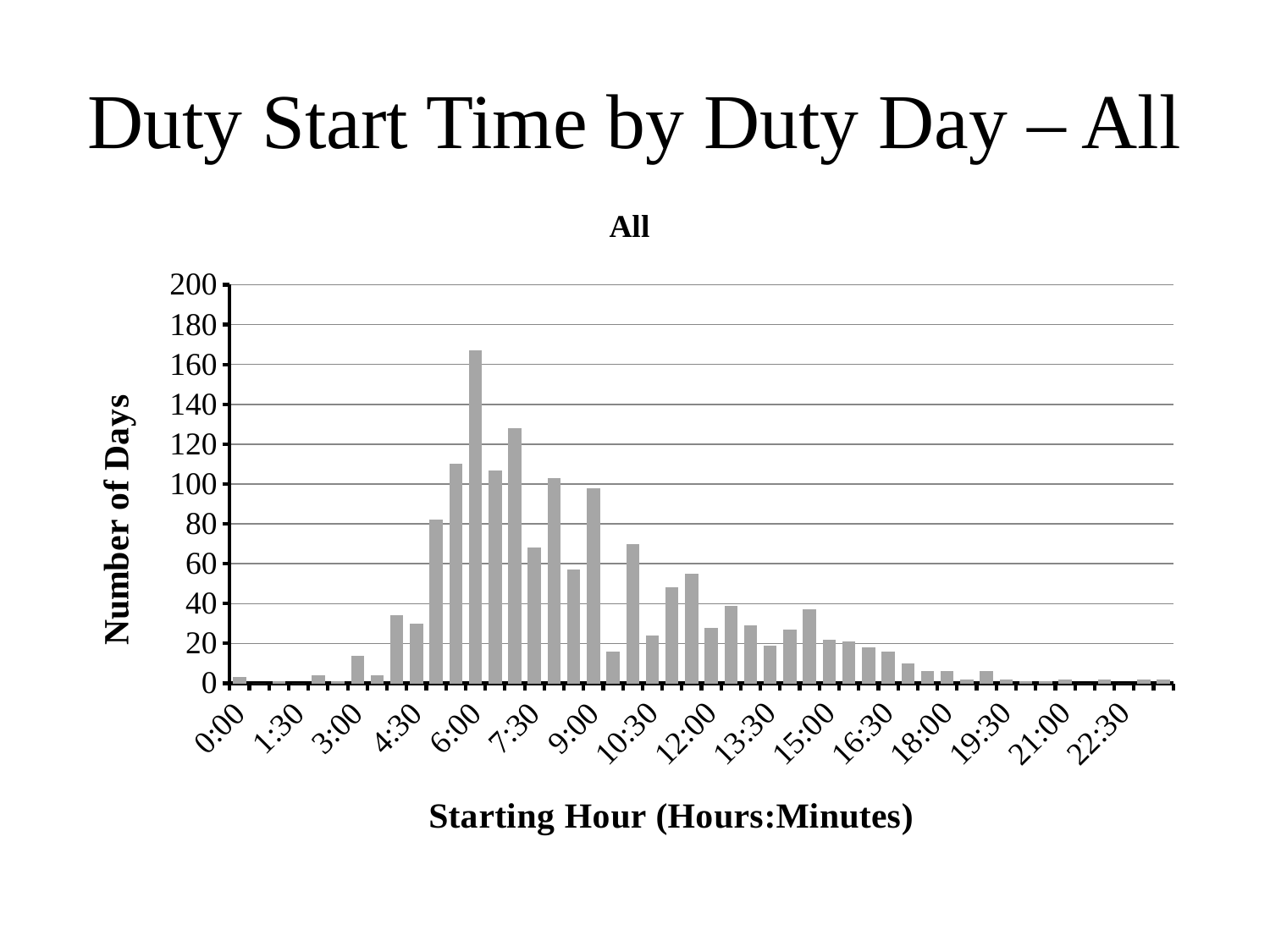
Do the number of days generally rise or fall along the x axis from 6:00 to 18:00? fall Is the number of days for the 6:00 starting hour greater or less than 140? greater What is the label of the horizontal axis? Starting Hour (Hours:Minutes) Is the number of days for the 18:00 starting hour greater or less than 20? less What is the label of the vertical axis? Number of Days Which starting hour has more days, 6:00 or 9:00? 6:00 Which starting hour has more days, 3:00 or 4:30? 4:30 Is the number of days for the 4:30 starting hour greater or less than 40? less What kind of chart is shown on the slide? bar chart Which starting hour has the highest number of days? 6:00